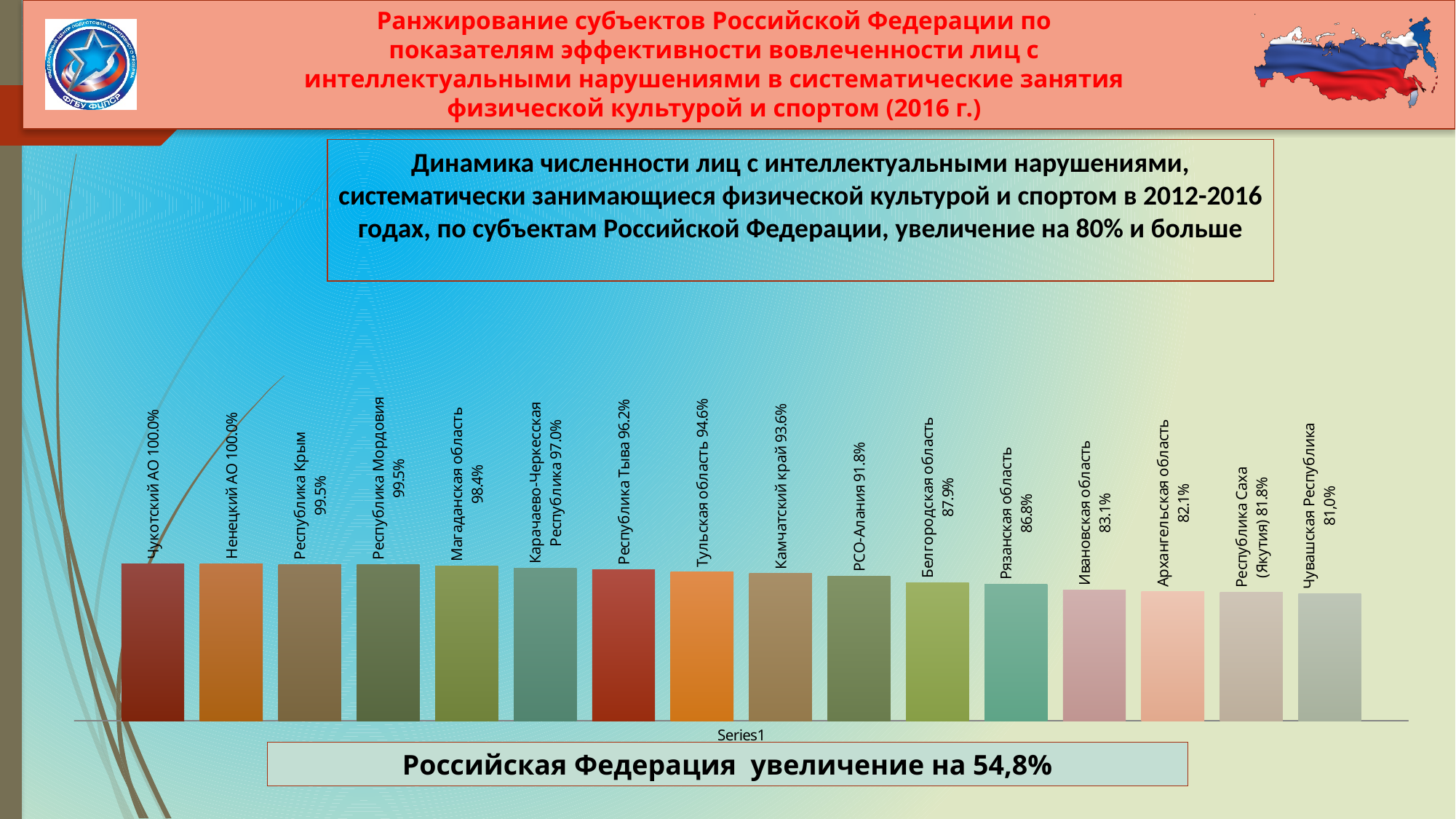
What is the value shown for Белгородская область? 87.9% What kind of chart is shown on the slide? bar chart What label appears under the bars on the x axis? Series1 Do the values rise or fall from left to right along the x axis? fall What is the value shown for Магаданская область? 98.4% What is the value shown for Республика Тыва? 96.2% What is the difference between the values for Магаданская область and Тульская область? 3.8 percentage points What is the value shown for Камчатский край? 93.6% How many regions (bars) are shown in the chart? 16 Which region has the lowest value in the chart? Чувашская Республика What is the value shown for Республика Саха (Якутия)? 81.8% Which has a larger value, Рязанская область or Ивановская область? Рязанская область